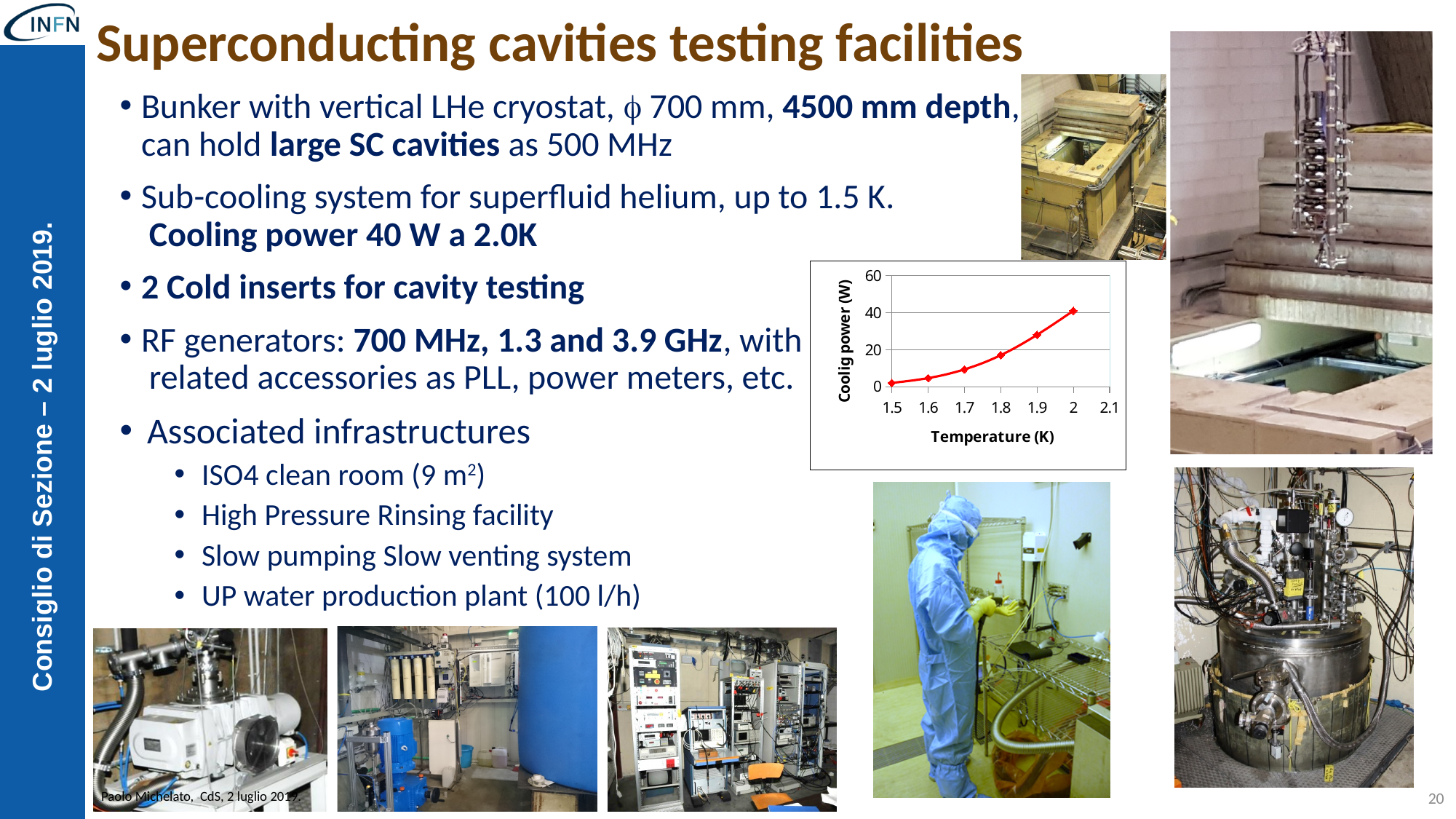
What is the label of the x axis of the chart? Temperature (K) Is the cooling power at 1.5 K greater or less than 20 W? less At which temperature is the cooling power highest? 2 What is the label of the y axis of the chart? Coolig power (W) At which temperature is the cooling power lowest? 1.5 Is the cooling power at 1.9 K greater or less than 20 W? greater How many data points are plotted on the chart? 6 What kind of chart is shown on the slide? line chart Which has the larger cooling power, 1.9 K or 1.6 K? 1.9 Is the cooling power at 1.7 K greater or less than 20 W? less Does the cooling power rise or fall as temperature increases along the x axis? rise